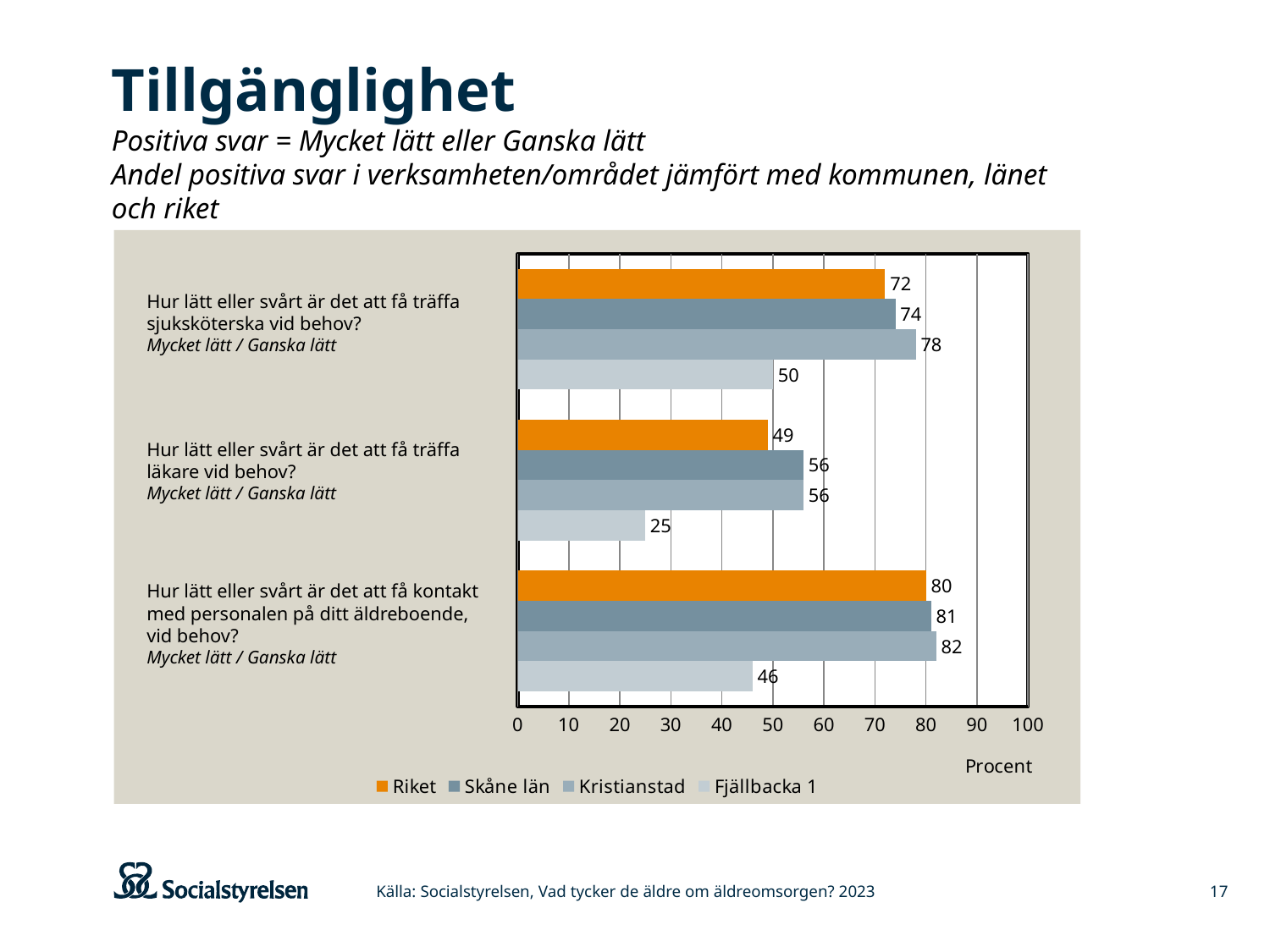
What is the value for Fjällbacka 1 on the question about meeting a nurse when needed ("Hur lätt eller svårt är det att få träffa sjuksköterska vid behov?")? 50 What is the difference between Skåne län and Riket on the question about meeting a nurse when needed? 2 Which series has the lowest value on the question about meeting a doctor when needed? Fjällbacka 1 What is the label on the horizontal axis of the chart? Procent How many series does the legend list? 4 What is the value for Kristianstad on the question about getting in contact with staff at the care home ("Hur lätt eller svårt är det att få kontakt med personalen på ditt äldreboende, vid behov?")? 82 What is the difference between Kristianstad and Fjällbacka 1 on the question about getting in contact with staff at the care home? 36 Which is larger: the Fjällbacka 1 value for meeting a nurse or the Fjällbacka 1 value for meeting a doctor? Meeting a nurse (50) Which series has the highest value on the question about meeting a nurse when needed? Kristianstad What kind of chart is shown on the slide? Bar chart How many questions (categories) are shown on the chart? 3 What is the value for Riket on the question about meeting a doctor when needed ("Hur lätt eller svårt är det att få träffa läkare vid behov?")? 49